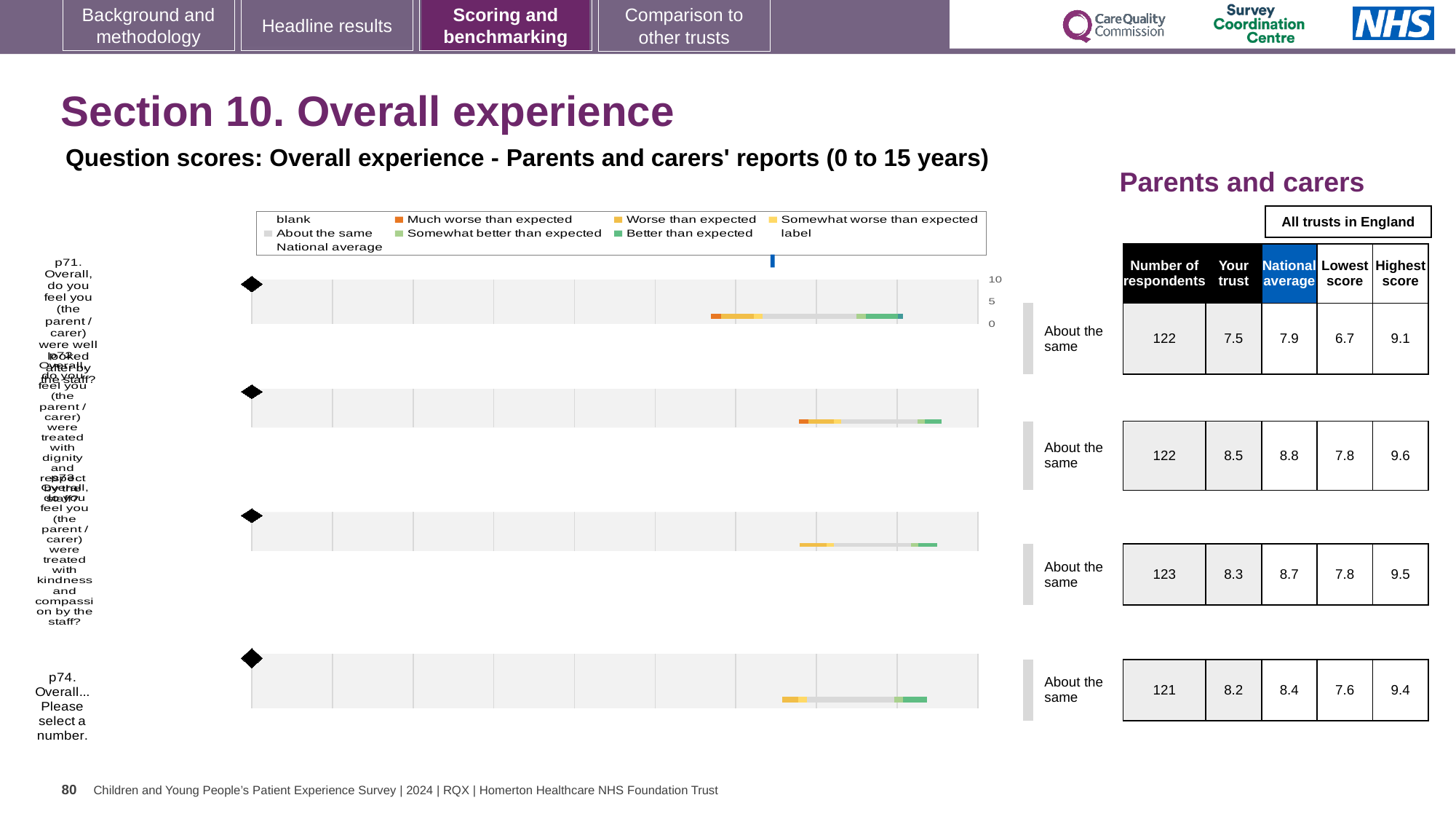
How many survey questions (rows) are plotted in the chart? 4 What kind of chart is used to show the question scores on this slide? bar chart What is the national average score for p74 (Overall... Please select a number)? 8.4 How many respondents answered p74? 121 What is the highest score across all trusts in England for p71? 9.1 What is the national average score for p71? 7.9 What is the title of the chart? Question scores: Overall experience - Parents and carers' reports (0 to 15 years) What benchmark category is shown for every question row in the chart? About the same How many entries does the chart legend list? 9 What is the 'Your trust' score for p71 (Overall, do you feel you were well looked after by the staff?)? 7.5 For p71, which is larger: the 'Your trust' score or the national average? National average What is the difference between the national average and the 'Your trust' score for p71? 0.4